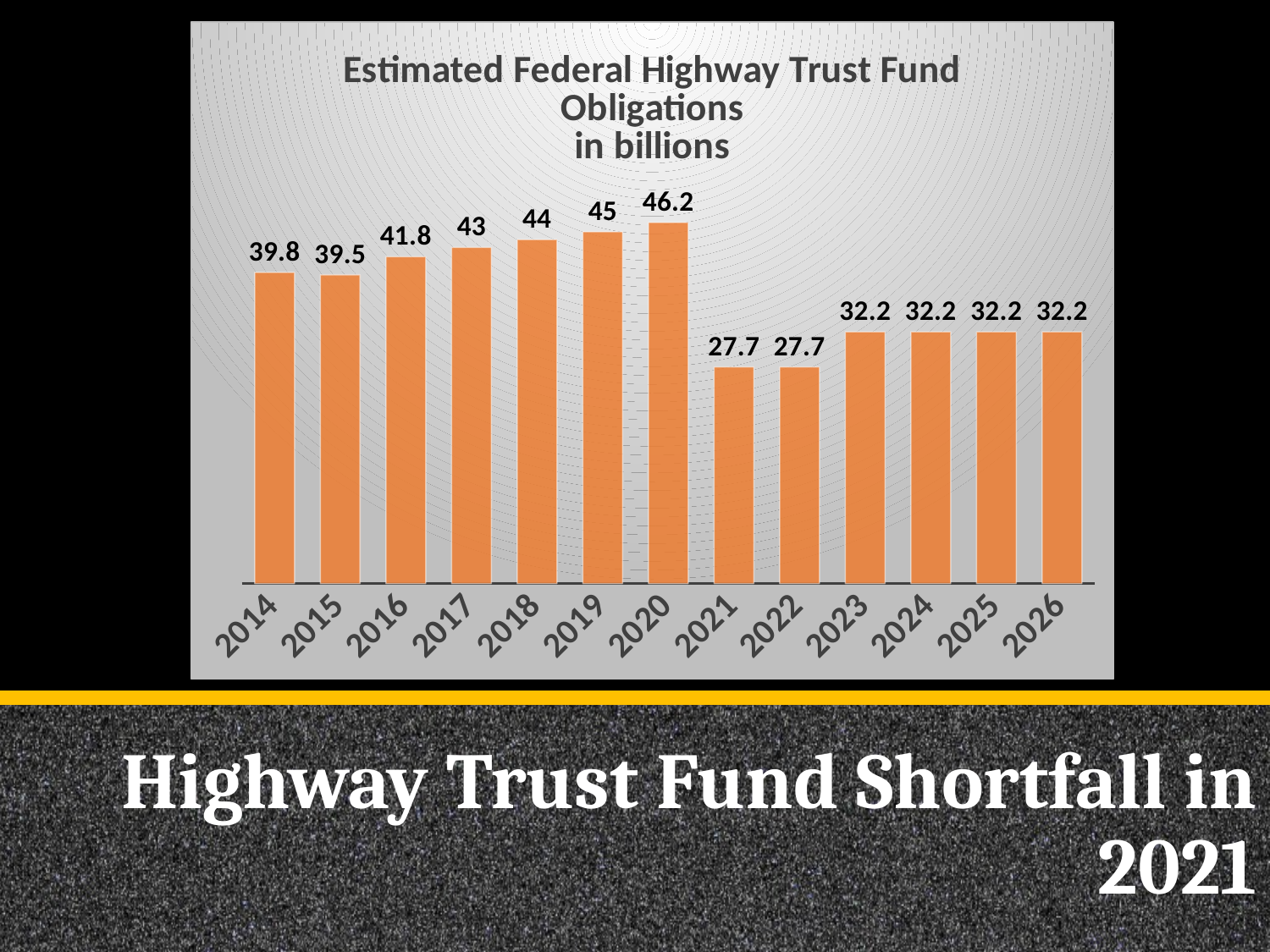
What is the estimated Federal Highway Trust Fund obligation for 2020? 46.2 What is the title of the chart? Estimated Federal Highway Trust Fund Obligations in billions How many years are shown on the x axis of the chart? 13 What is the estimated Federal Highway Trust Fund obligation for 2021? 27.7 What is the difference between the 2016 value and the 2015 value? 2.3 What kind of chart is shown on the slide? Bar chart What is the estimated Federal Highway Trust Fund obligation for 2014? 39.8 What is the difference between the 2020 value and the 2021 value? 18.5 Do the values rise or fall from 2015 to 2020? Rise What is the lowest value shown on the chart? 27.7 Which is larger, the value for 2019 or the value for 2023? 2019 Which year has the highest estimated obligation? 2020